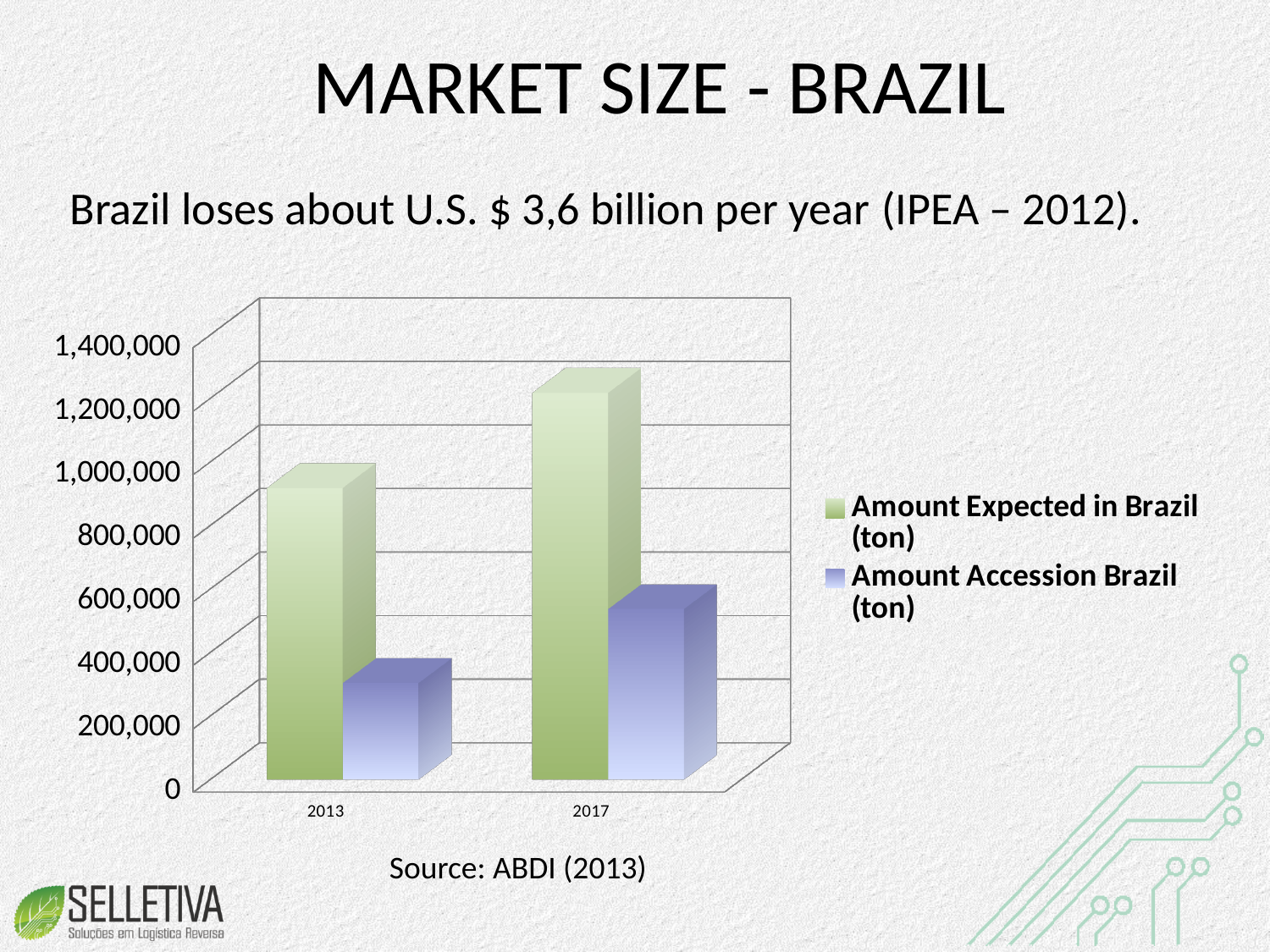
Is the value for Amount Expected in Brazil (ton) in 2013 greater or less than 800,000? greater Is the value for Amount Accession Brazil (ton) in 2017 greater or less than 800,000? less Is the value for Amount Expected in Brazil (ton) in 2017 greater or less than 1,000,000? greater Which year and series has the tallest bar in the chart? Amount Expected in Brazil (ton), 2017 In 2013, which is larger: Amount Expected in Brazil (ton) or Amount Accession Brazil (ton)? Amount Expected in Brazil (ton) What colour are the bars for the Amount Expected in Brazil (ton) series? green How many series does the chart legend list? 2 Does the Amount Accession Brazil (ton) series rise or fall from 2013 to 2017? rise Which year and series has the shortest bar in the chart? Amount Accession Brazil (ton), 2013 What kind of chart is shown on the slide? bar chart How many categories (years) are shown on the x axis of the chart? 2